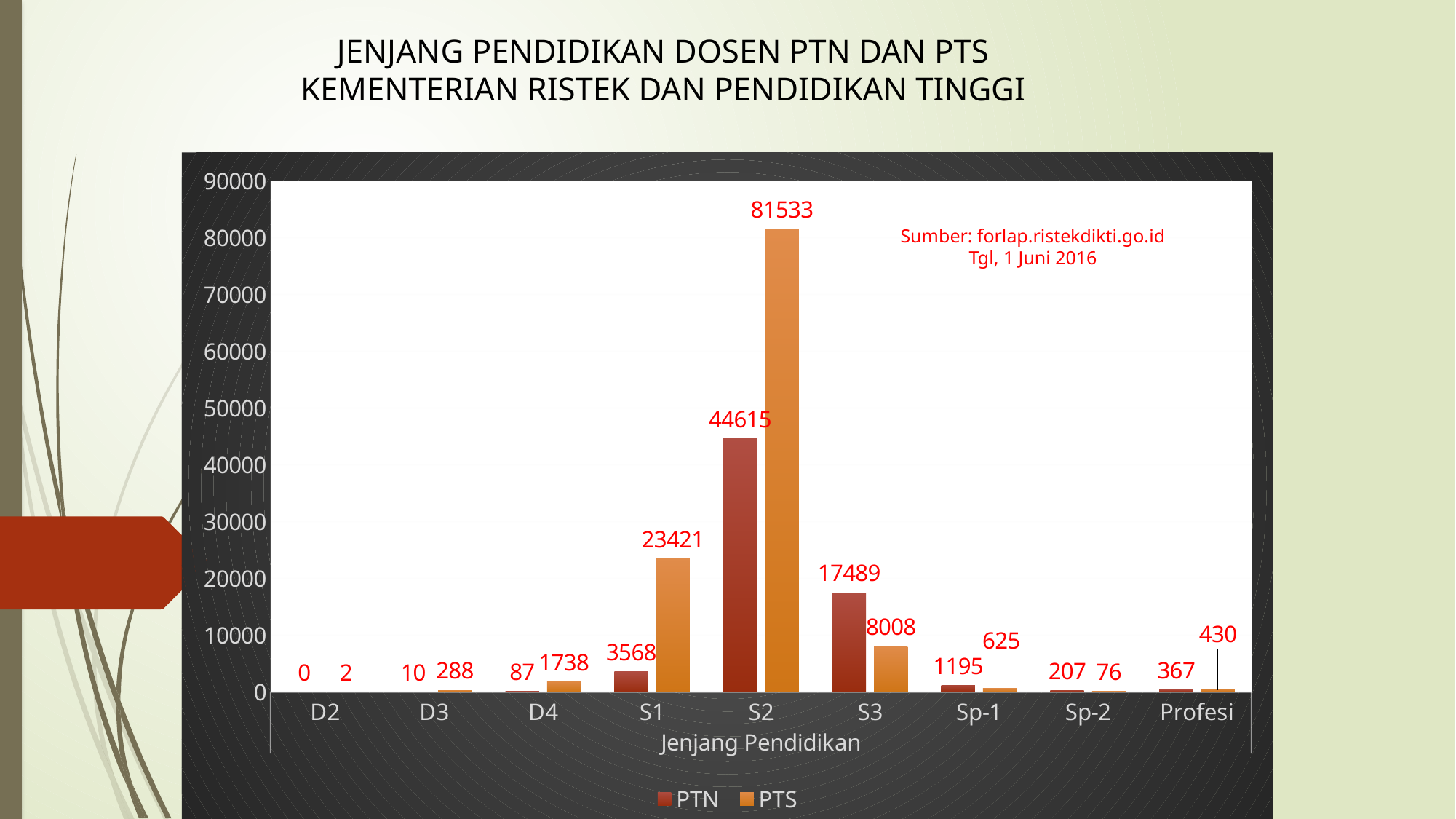
Which category has the lowest PTN value? D2 What is the PTS value for D4? 1738 For S3, which is larger, the PTN value or the PTS value? PTN How many categories are shown on the x axis? 9 Is the PTN value for S2 greater or less than 40000? greater What is the PTN value for Sp-1? 1195 What is the difference between the PTS and PTN values for S2? 36918 What kind of chart is shown on the slide? bar chart What is the PTN value for S3? 17489 How many series does the legend list? 2 What is the PTS value for S2? 81533 Which category has the highest PTN value? S2